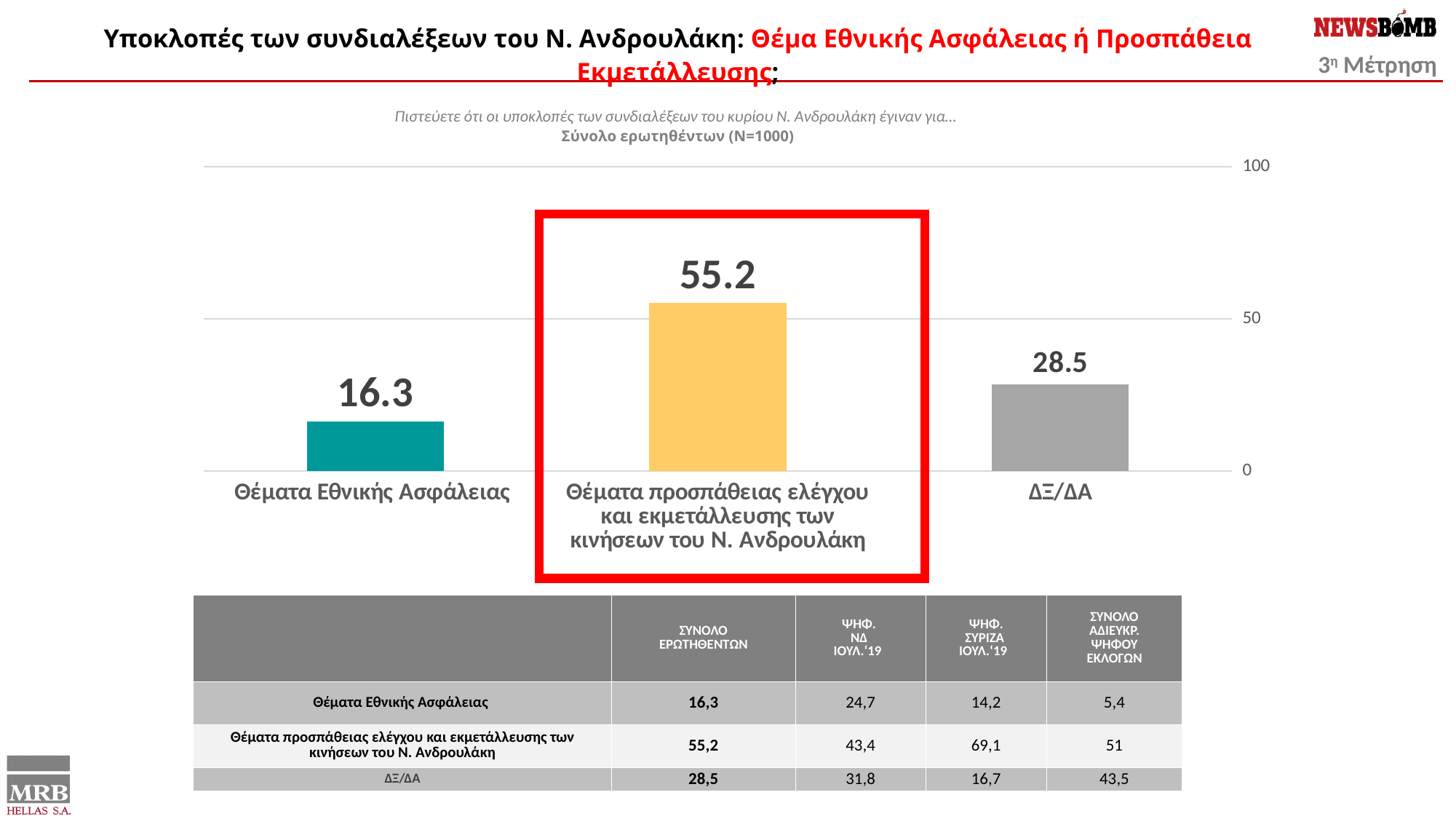
Which is larger: the value for ΔΞ/ΔΑ or the value for Θέματα Εθνικής Ασφάλειας? ΔΞ/ΔΑ What is the value for Θέματα Εθνικής Ασφάλειας in the chart? 16.3 Which category has the highest value in the chart? Θέματα προσπάθειας ελέγχου και εκμετάλλευσης των κινήσεων του Ν. Ανδρουλάκη What kind of chart is shown on the slide? bar chart What is the difference between the values for ΔΞ/ΔΑ and Θέματα Εθνικής Ασφάλειας? 12.2 What is the value for ΔΞ/ΔΑ in the chart? 28.5 What is the difference between the values for Θέματα προσπάθειας ελέγχου και εκμετάλλευσης των κινήσεων του Ν. Ανδρουλάκη and Θέματα Εθνικής Ασφάλειας? 38.9 Which category has the lowest value in the chart? Θέματα Εθνικής Ασφάλειας How many categories are shown in the chart? 3 Which bar in the chart is highlighted with a red box? Θέματα προσπάθειας ελέγχου και εκμετάλλευσης των κινήσεων του Ν. Ανδρουλάκη What is the value for Θέματα προσπάθειας ελέγχου και εκμετάλλευσης των κινήσεων του Ν. Ανδρουλάκη in the chart? 55.2 Is the value for Θέματα προσπάθειας ελέγχου και εκμετάλλευσης των κινήσεων του Ν. Ανδρουλάκη greater or less than 50? greater